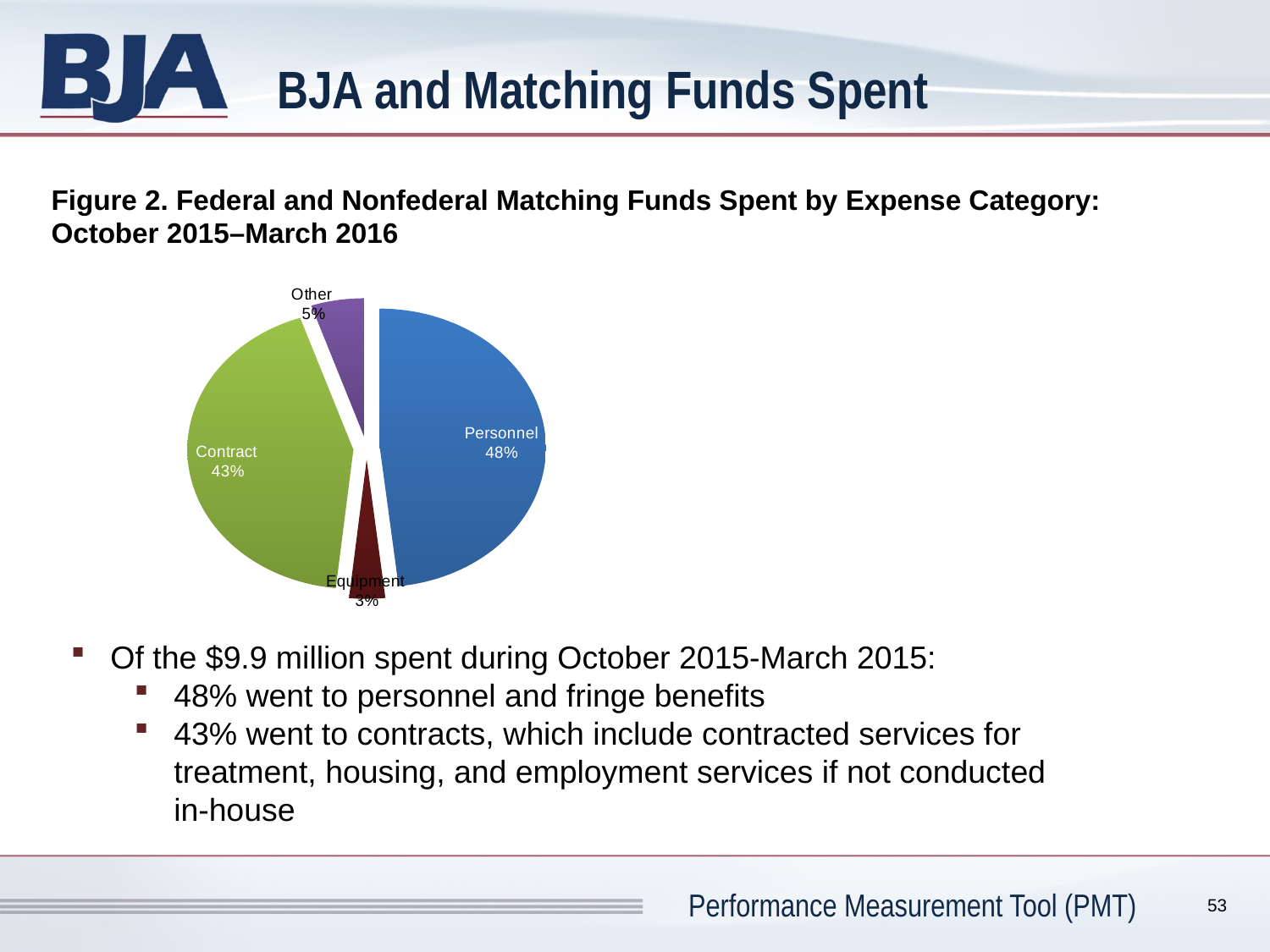
What share of funds spent went to Other? 5% Which expense category has the smallest share of the pie? Equipment Which expense category has the largest share of the pie? Personnel What share of funds spent went to Personnel? 48% Which is larger, the share for Other or the share for Equipment? Other What share of funds spent went to Equipment? 3% What is the difference in percentage points between the Personnel and Contract shares? 5 What is the combined share of Personnel and Contract? 91% What kind of chart is shown on the slide? Pie chart What colour is the Contract slice of the pie? Green What share of funds spent went to Contract? 43% How many expense categories are shown in the pie chart? 4